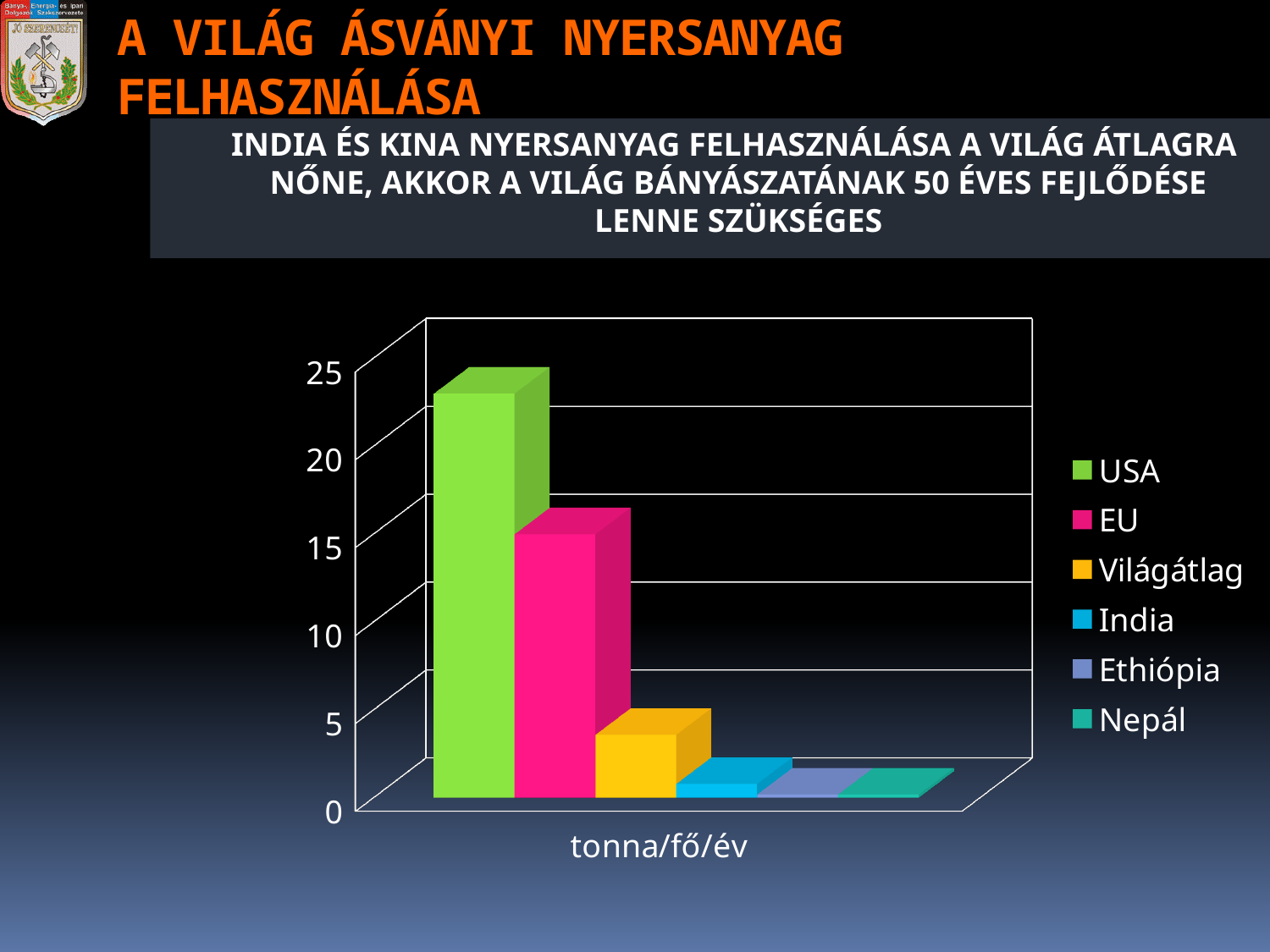
Which is larger, the value for Világátlag or the value for India? Világátlag Is the value for Világátlag greater or less than 5? less Is the value for EU greater or less than 10? greater What unit label is shown below the chart's horizontal axis? tonna/fő/év Which series has the highest value? USA Which is larger, the value for USA or the value for EU? USA Is the value for USA greater or less than 20? greater What kind of chart is shown on the slide? bar chart What colour is the bar for EU? pink How many series does the legend list? 6